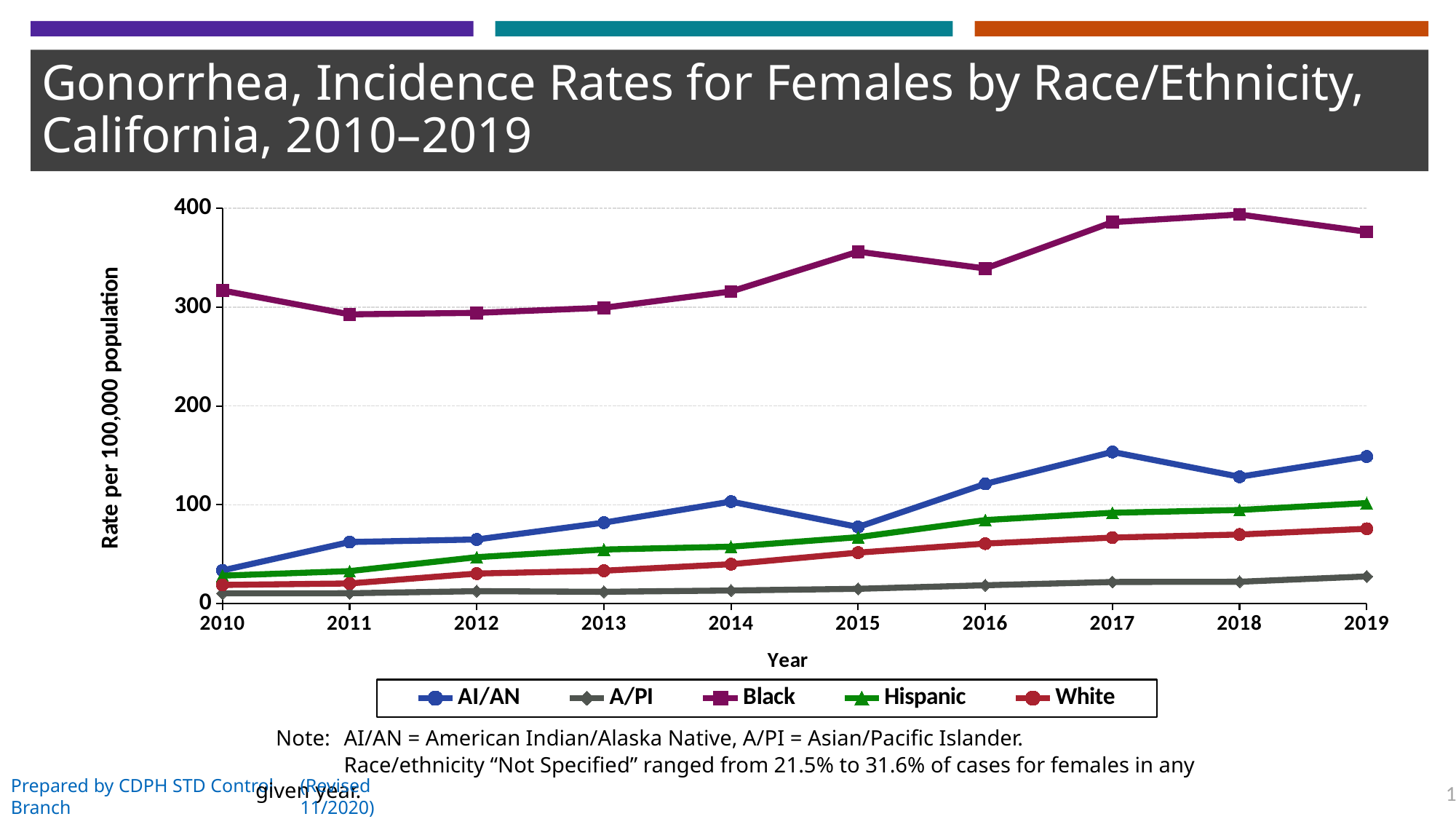
Is the value for AI/AN in 2017 greater or less than 100? greater Does the Hispanic series rise or fall from 2010 to 2019? rise Is the value for Black in 2018 greater or less than 300? greater How many series does the legend list? 5 How many years are plotted along the x axis? 10 What kind of chart is shown on the slide? line chart Is the value for AI/AN in 2015 greater or less than 100? less Which is larger in 2017, the rate for AI/AN or the rate for Hispanic? AI/AN In which year does the AI/AN series reach its highest value? 2017 Which race/ethnicity group has the highest gonorrhea incidence rate in 2019? Black In which year does the Black series reach its highest value? 2018 Which race/ethnicity group has the lowest gonorrhea incidence rate in 2019? A/PI